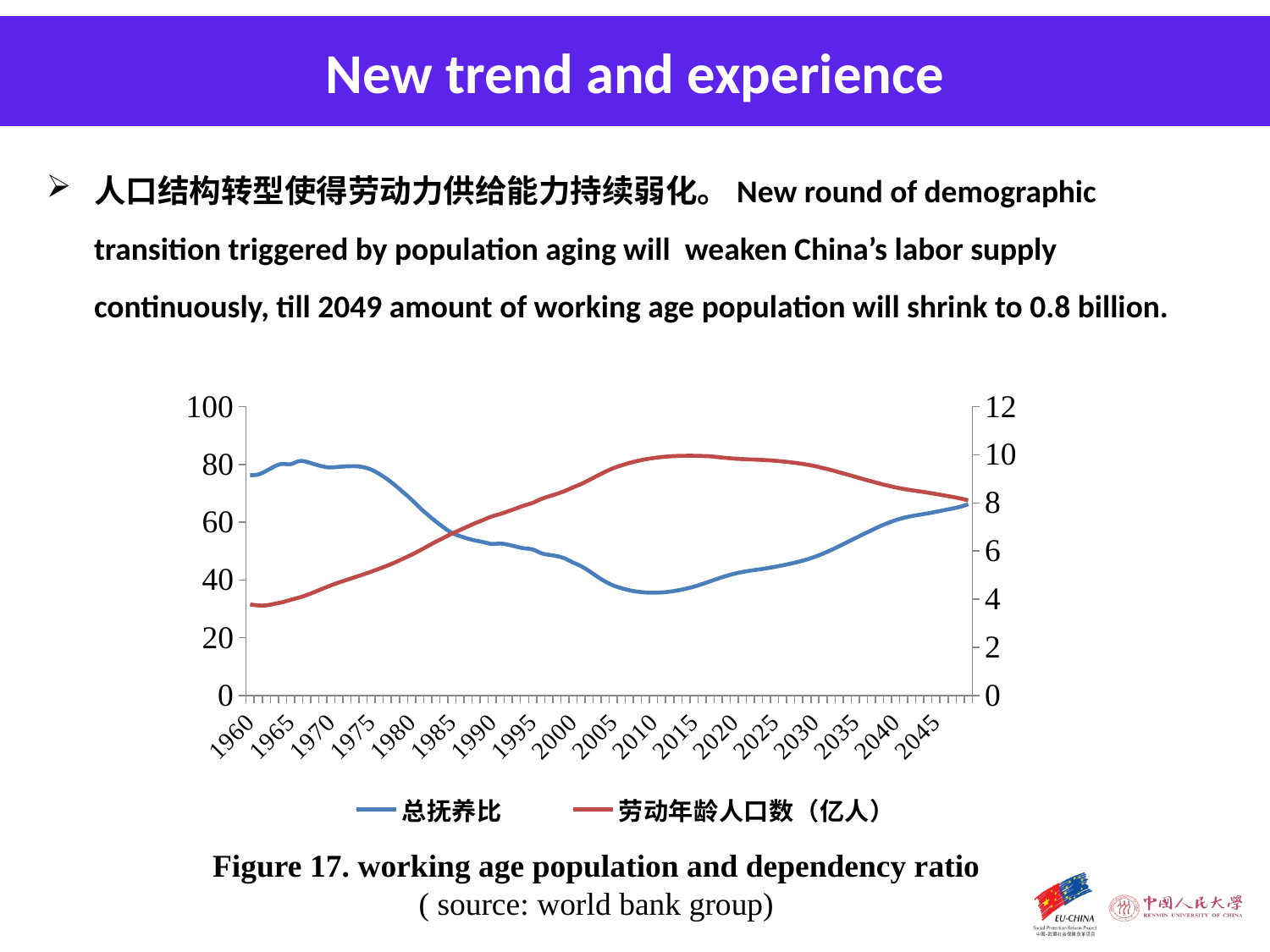
Does the blue 总抚养比 line rise or fall between 1975 and 2010? Fall Is the value of the blue 总抚养比 line at 1960 greater or less than 60 on the left axis? greater Does the red 劳动年龄人口数 line rise or fall between 1960 and 2015? Rise Around which year does the red 劳动年龄人口数 line reach its highest point? 2015 What are the two series named in the chart legend? 总抚养比 and 劳动年龄人口数（亿人） What is the caption of the figure below the chart? Figure 17. working age population and dependency ratio Is the value of the red 劳动年龄人口数 line at 2015 greater or less than 8 on the right axis? greater What kind of chart is shown on the slide? Line chart Is the value of the red 劳动年龄人口数 line at 1960 greater or less than 6 on the right axis? less How many series does the chart legend list? 2 How many year labels are shown on the x axis of the chart? 18